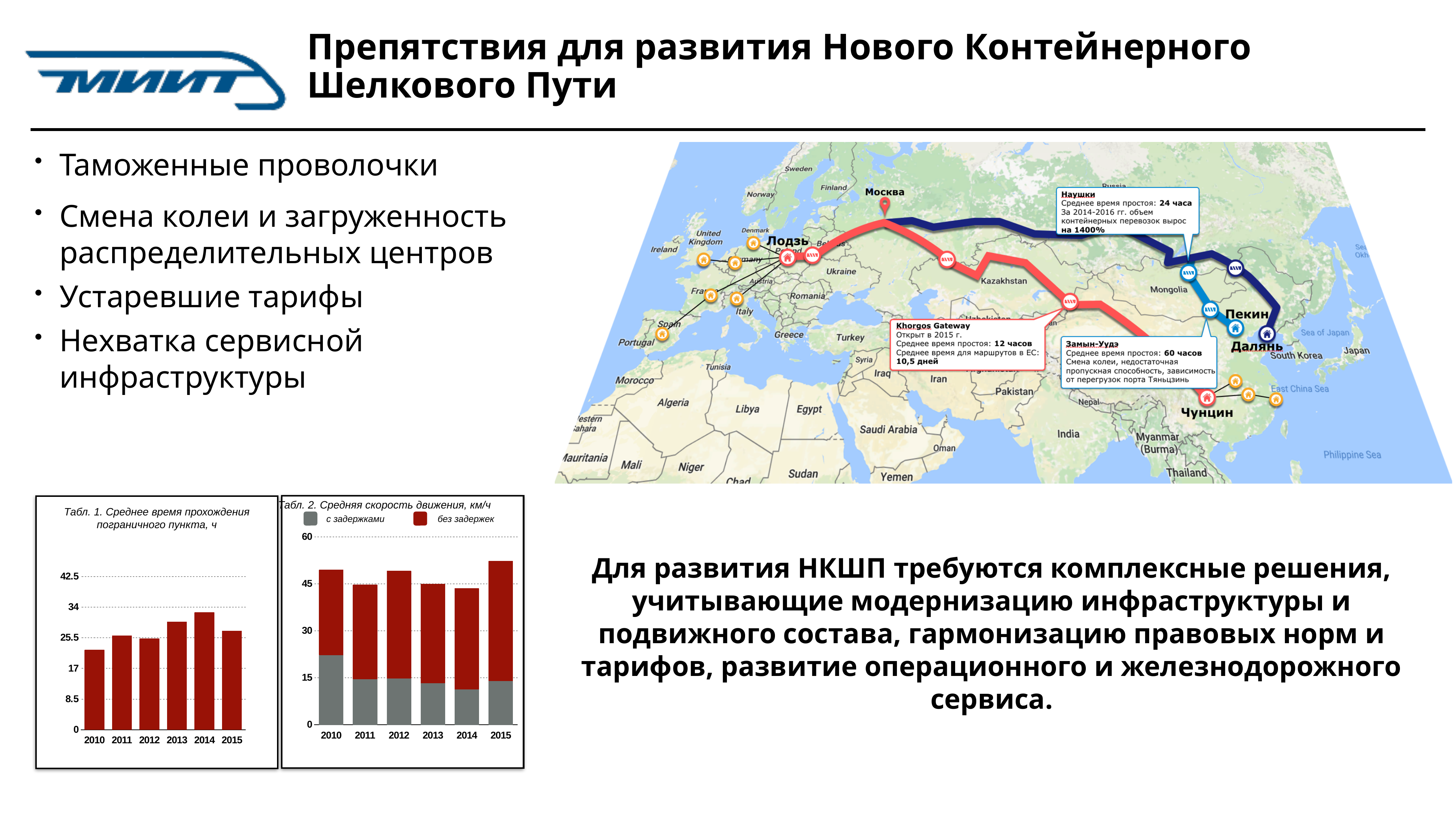
In Табл. 2 (Средняя скорость движения, км/ч), which year has the highest value for 'с задержками'? 2010 In Табл. 1 (Среднее время прохождения пограничного пункта), which year has the lowest value? 2010 In Табл. 1 (Среднее время прохождения пограничного пункта), is the value for 2014 greater or less than 25.5? greater How many years are shown on the x axis of Табл. 1 (Среднее время прохождения пограничного пункта)? 6 In Табл. 1 (Среднее время прохождения пограничного пункта), is the value for 2010 greater or less than 25.5? less In Табл. 1 (Среднее время прохождения пограничного пункта), which year has the highest value? 2014 In Табл. 2 (Средняя скорость движения, км/ч), which colour represents 'без задержек'? dark red In Табл. 1 (Среднее время прохождения пограничного пункта), do the values rise or fall from 2010 to 2014? rise In Табл. 2 (Средняя скорость движения, км/ч), which year has the lowest value for 'с задержками'? 2014 In Табл. 2 (Средняя скорость движения, км/ч), is the value for 'с задержками' in 2010 greater or less than 15? greater What kind of chart is Табл. 1 (Среднее время прохождения пограничного пункта)? bar chart How many series does the legend of Табл. 2 (Средняя скорость движения, км/ч) list? 2